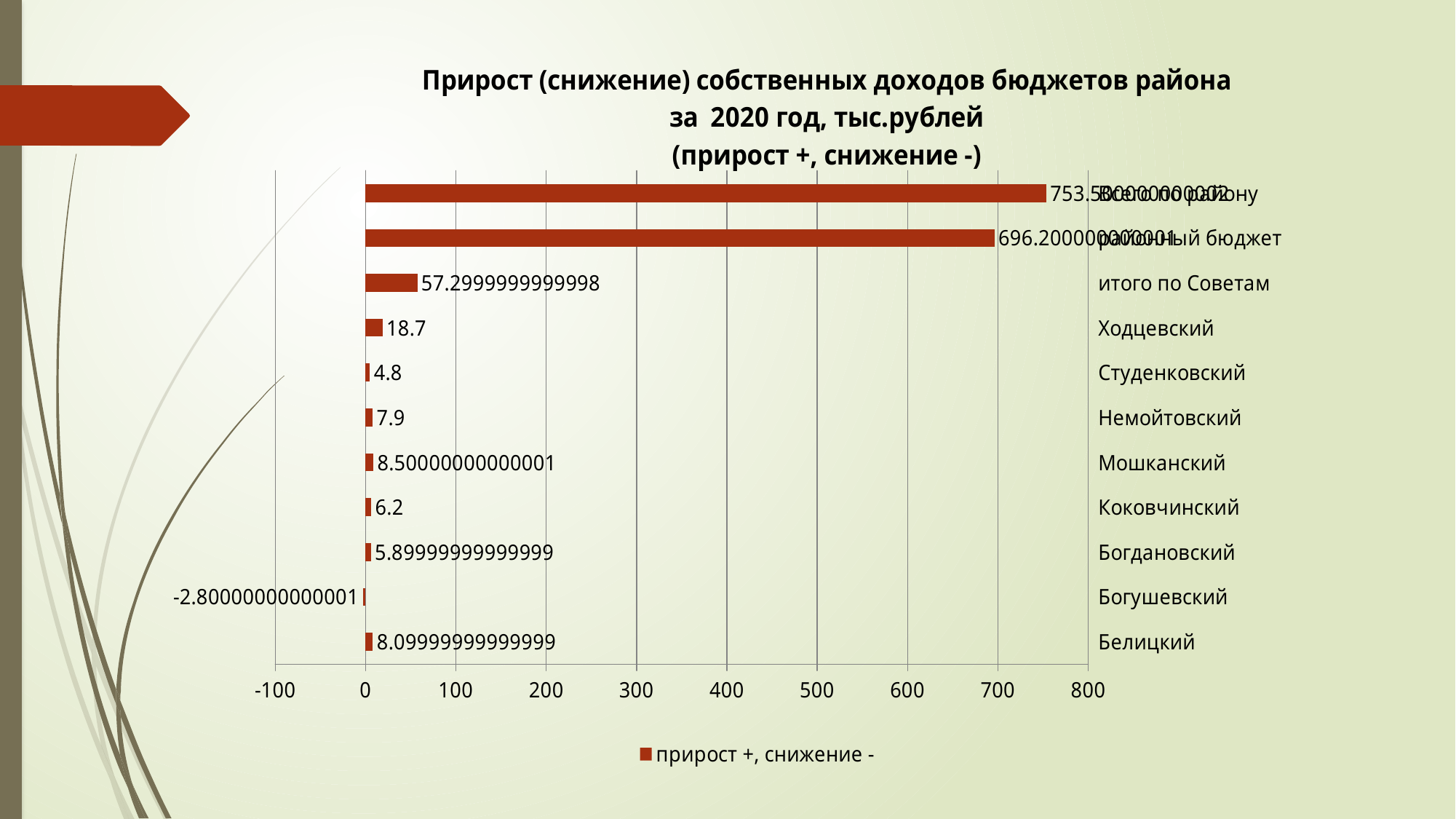
How many categories are plotted on the chart? 11 What is the value for Ходцевский? 18.7 What kind of chart is shown on the slide? bar chart What is the value for Коковчинский? 6.2 Which is larger, the value for Ходцевский or the value for Студенковский? Ходцевский What is the legend entry shown below the chart? прирост +, снижение - Is the value for районный бюджет greater or less than 600? greater Which category has the highest value? Всего по району What is the value for Немойтовский? 7.9 Which category has the lowest value? Богушевский Is the value for Всего по району greater or less than 700? greater What is the value for Студенковский? 4.8